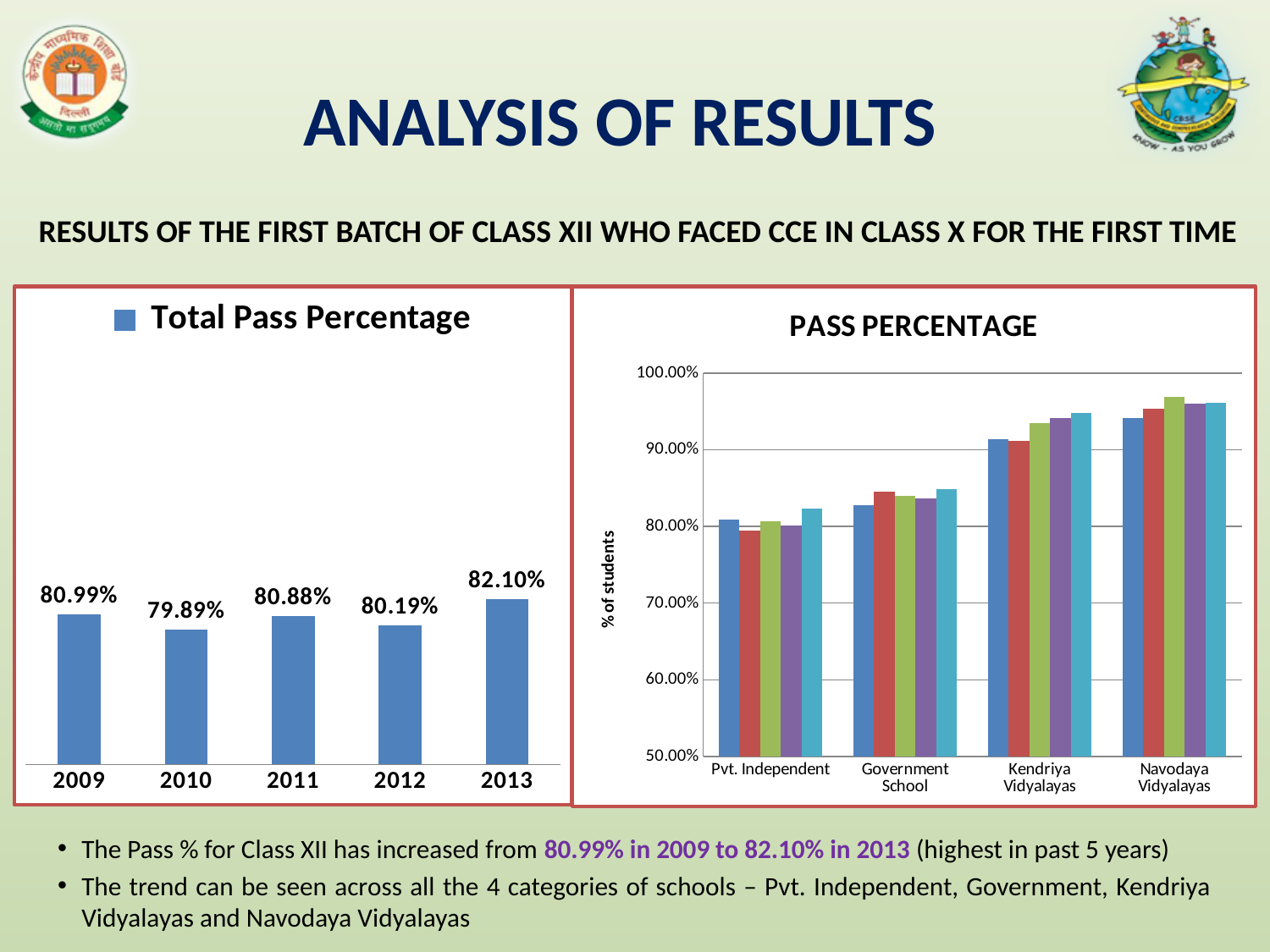
In the 'PASS PERCENTAGE' chart on the right, are the values for Navodaya Vidyalayas greater or less than 90.00%? greater In the 'Total Pass Percentage' chart on the left, what is the value for 2010? 79.89% What is the y-axis title of the 'PASS PERCENTAGE' chart on the right? % of students How many years are shown in the 'Total Pass Percentage' chart on the left? 5 In the 'Total Pass Percentage' chart on the left, which year has the larger value, 2011 or 2012? 2011 What kind of chart is the 'Total Pass Percentage' chart on the left? Bar chart How many school categories are shown on the x axis of the 'PASS PERCENTAGE' chart on the right? 4 In the 'Total Pass Percentage' chart on the left, which year has the highest pass percentage? 2013 In the 'Total Pass Percentage' chart on the left, which year has the lowest pass percentage? 2010 In the 'Total Pass Percentage' chart on the left, what is the difference between the values for 2013 and 2009? 1.11% In the 'Total Pass Percentage' chart on the left, what is the value for 2013? 82.10% In the 'PASS PERCENTAGE' chart on the right, which school category has the lowest pass percentages? Pvt. Independent